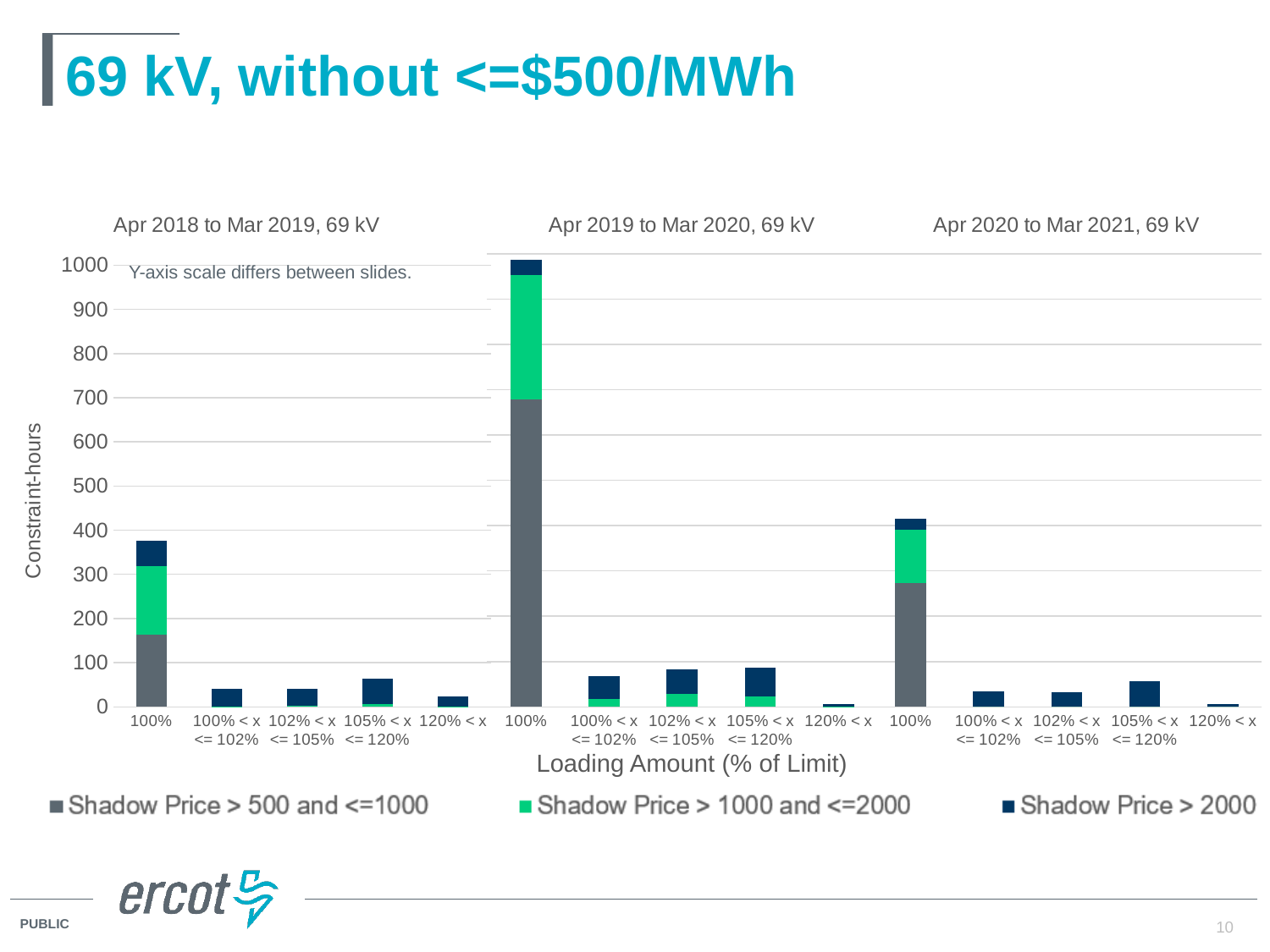
In the Apr 2019 to Mar 2020, 69 kV chart, which loading amount category has the lowest total constraint-hours? 120% < x In the Apr 2020 to Mar 2021, 69 kV chart, which is larger: the total for 105% < x <= 120% or the total for 120% < x? 105% < x <= 120% In the Apr 2020 to Mar 2021, 69 kV chart, is the total for the 100% category greater or less than 500? less What is the title of the x-axis? Loading Amount (% of Limit) What kind of chart is shown on the slide? bar chart Which chart has the taller 100% bar: Apr 2018 to Mar 2019, 69 kV or Apr 2019 to Mar 2020, 69 kV? Apr 2019 to Mar 2020, 69 kV In the Apr 2018 to Mar 2019, 69 kV chart, is the total for the 100% category greater or less than 300? greater In the Apr 2019 to Mar 2020, 69 kV chart, how many loading amount categories are shown? 5 In the Apr 2019 to Mar 2020, 69 kV chart, is the total for the 100% category greater or less than 900? greater How many series does the legend list? 3 What is the label of the y-axis? Constraint-hours In the Apr 2019 to Mar 2020, 69 kV chart, which loading amount category has the highest total constraint-hours? 100%